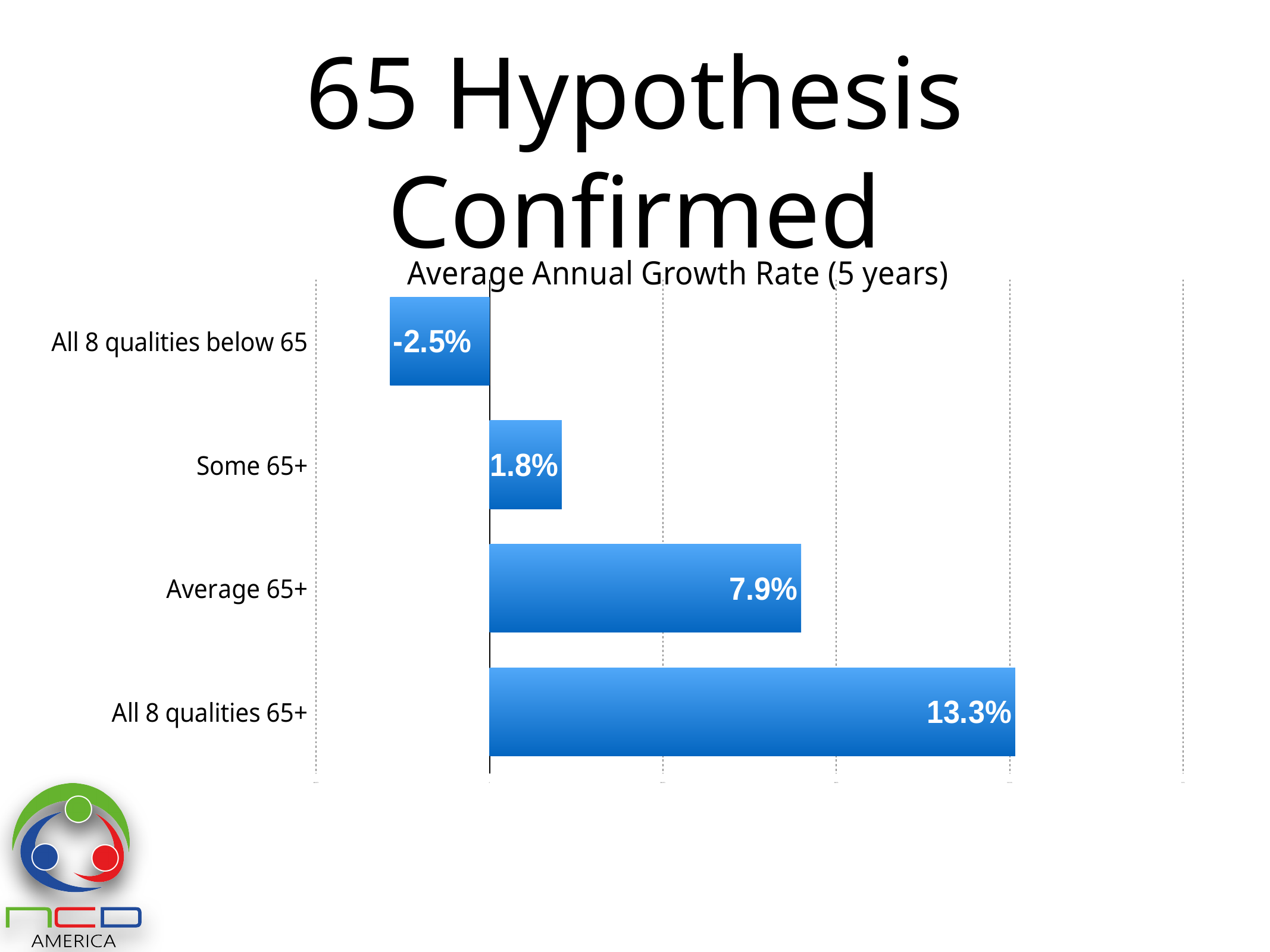
How many categories are shown in the chart? 4 Which has a higher growth rate, 'Some 65+' or 'Average 65+'? Average 65+ Which category has the lowest average annual growth rate? All 8 qualities below 65 What is the average annual growth rate for 'All 8 qualities below 65'? -2.5% What is the average annual growth rate for 'Some 65+'? 1.8% Which category has the highest average annual growth rate? All 8 qualities 65+ What is the average annual growth rate for 'All 8 qualities 65+'? 13.3% What is the difference between the growth rates of 'All 8 qualities 65+' and 'Average 65+'? 5.4% What is the average annual growth rate for 'Average 65+'? 7.9% What is the difference between the growth rates of 'Some 65+' and 'All 8 qualities below 65'? 4.3% What is the title of the chart? Average Annual Growth Rate (5 years) What type of chart is shown on the slide? Bar chart